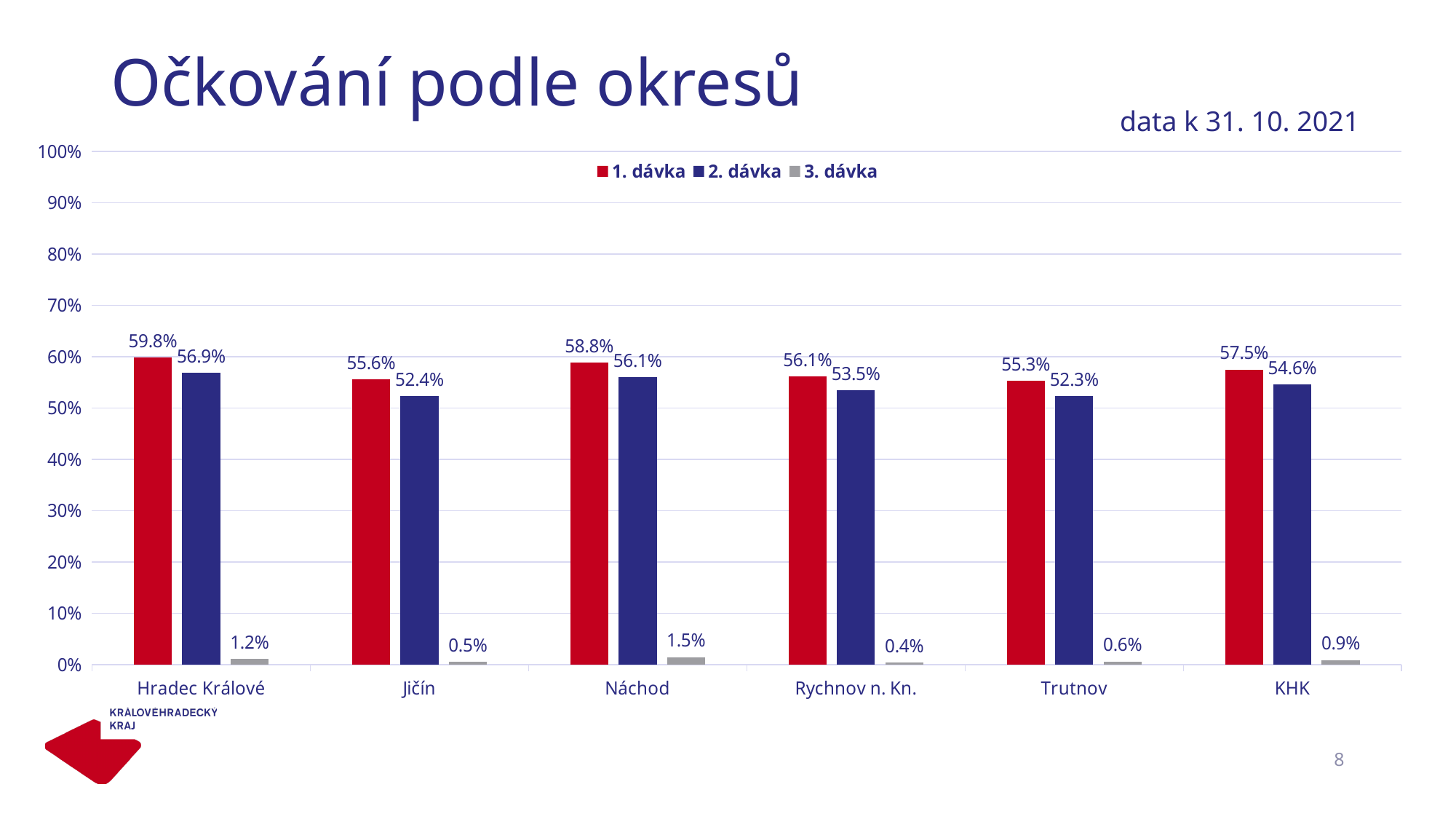
Which is larger: 2. dávka for Náchod or 2. dávka for KHK? Náchod Which district has the highest value for 1. dávka? Hradec Králové What is the value of 3. dávka for Náchod? 1.5% Which category has the lowest value for 3. dávka? Rychnov n. Kn. How many series does the legend list? 3 How many categories are shown on the x axis? 6 What is the value of 2. dávka for Jičín? 52.4% What kind of chart is shown on the slide? bar chart What is the title of the chart? Očkování podle okresů What is the value of 1. dávka for Hradec Králové? 59.8% What is the difference between 1. dávka and 2. dávka for Trutnov? 3.0% Is the value of 1. dávka for Jičín greater or less than 60%? less